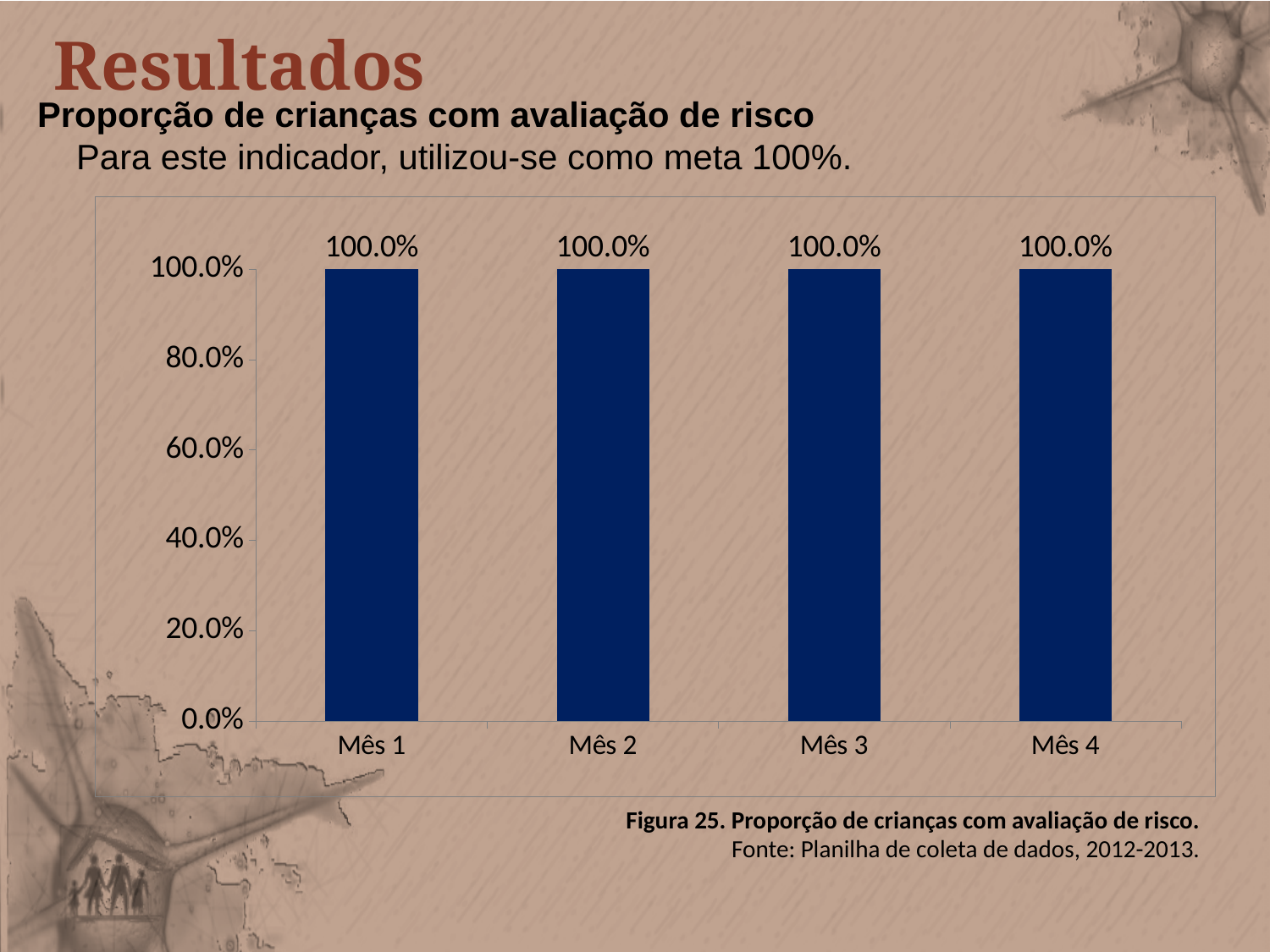
What is the difference between the values for Mês 2 and Mês 4? 0.0% What is the value for Mês 3? 100.0% What is the value for Mês 4? 100.0% What source is cited for the chart data? Planilha de coleta de dados, 2012-2013 What is the value for Mês 1? 100.0% Is the value for Mês 1 larger than, smaller than, or equal to the value for Mês 2? Equal Do the values rise, fall, or stay the same from Mês 1 to Mês 4? Stay the same What is the figure number given in the caption below the chart? Figura 25 Is the value for Mês 3 greater or less than 80.0%? greater How many categories (months) are shown on the x axis? 4 What kind of chart is shown on the slide? Bar chart